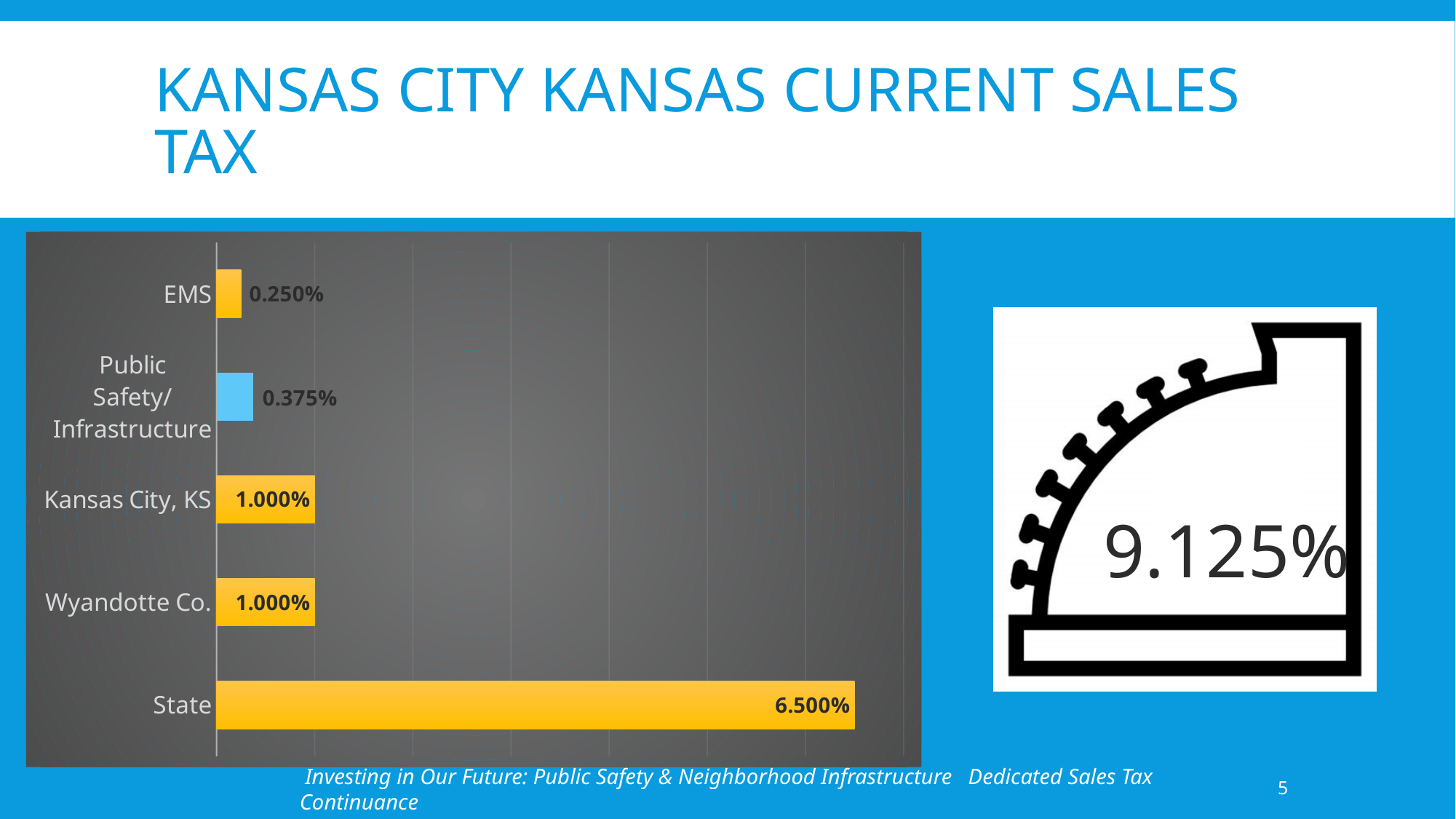
What is the value for EMS? 0.250% Which category has the highest value? State Which category has the lowest value? EMS How many categories are shown in the chart? 5 Which is larger, the value for Public Safety/Infrastructure or the value for EMS? Public Safety/Infrastructure What is the value for State? 6.500% What kind of chart is shown on the slide? bar chart Which category's bar is coloured blue rather than yellow? Public Safety/Infrastructure What is the difference between the Public Safety/Infrastructure value and the EMS value? 0.125% What is the value for Wyandotte Co.? 1.000% What is the value for Public Safety/Infrastructure? 0.375% What is the difference between the State value and the Kansas City, KS value? 5.500%